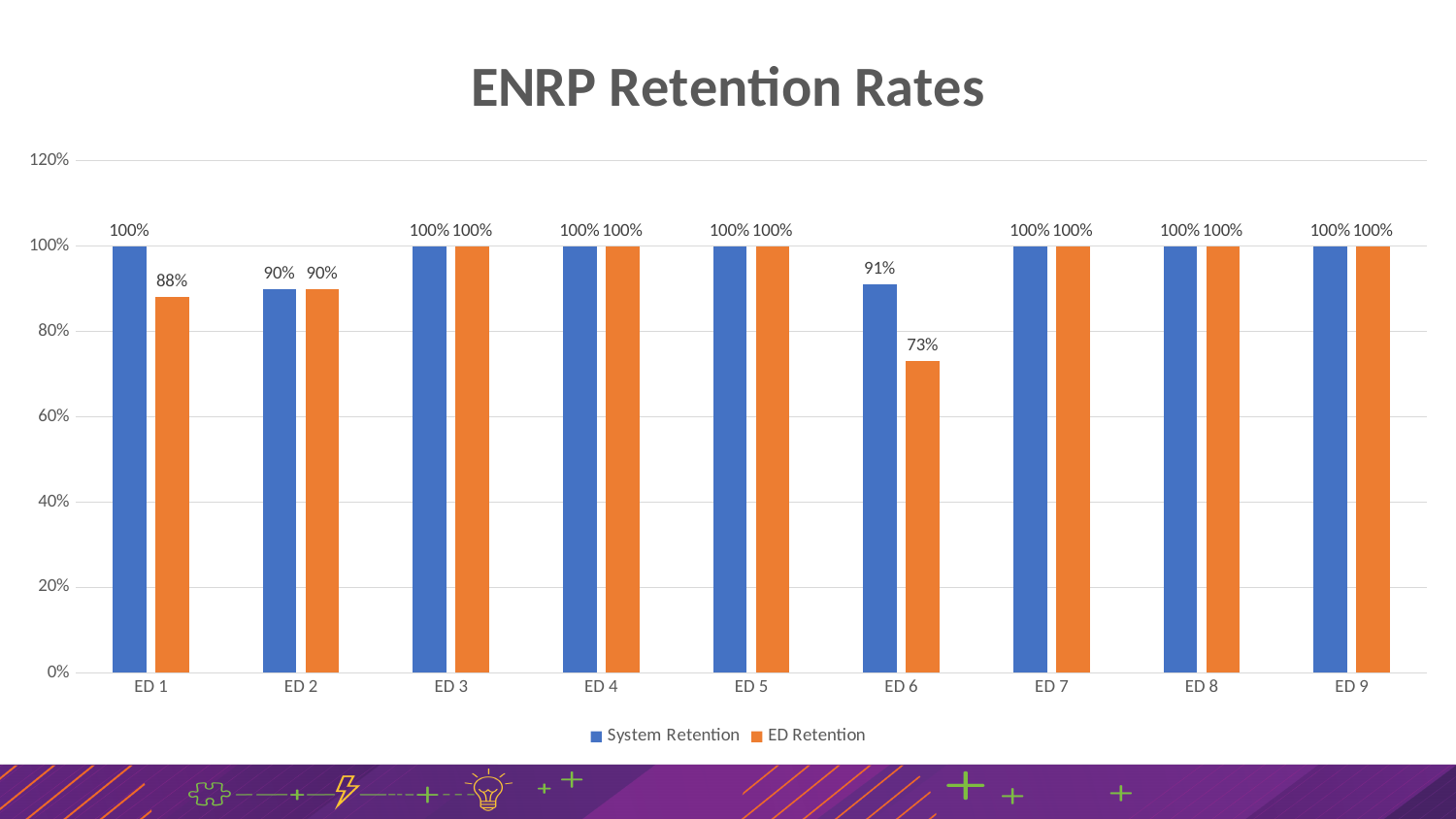
How many EDs are shown on the x axis? 9 What is the title of the chart? ENRP Retention Rates What is the difference between System Retention and ED Retention for ED 6? 18% Which ED has the lowest System Retention value? ED 2 What is the ED Retention value for ED 6? 73% Which is larger for ED 1, System Retention or ED Retention? System Retention What kind of chart is shown on the slide? Bar chart What is the System Retention value for ED 1? 100% How many series does the legend list? 2 What is the System Retention value for ED 6? 91% Which ED has the lowest ED Retention value? ED 6 What is the ED Retention value for ED 1? 88%